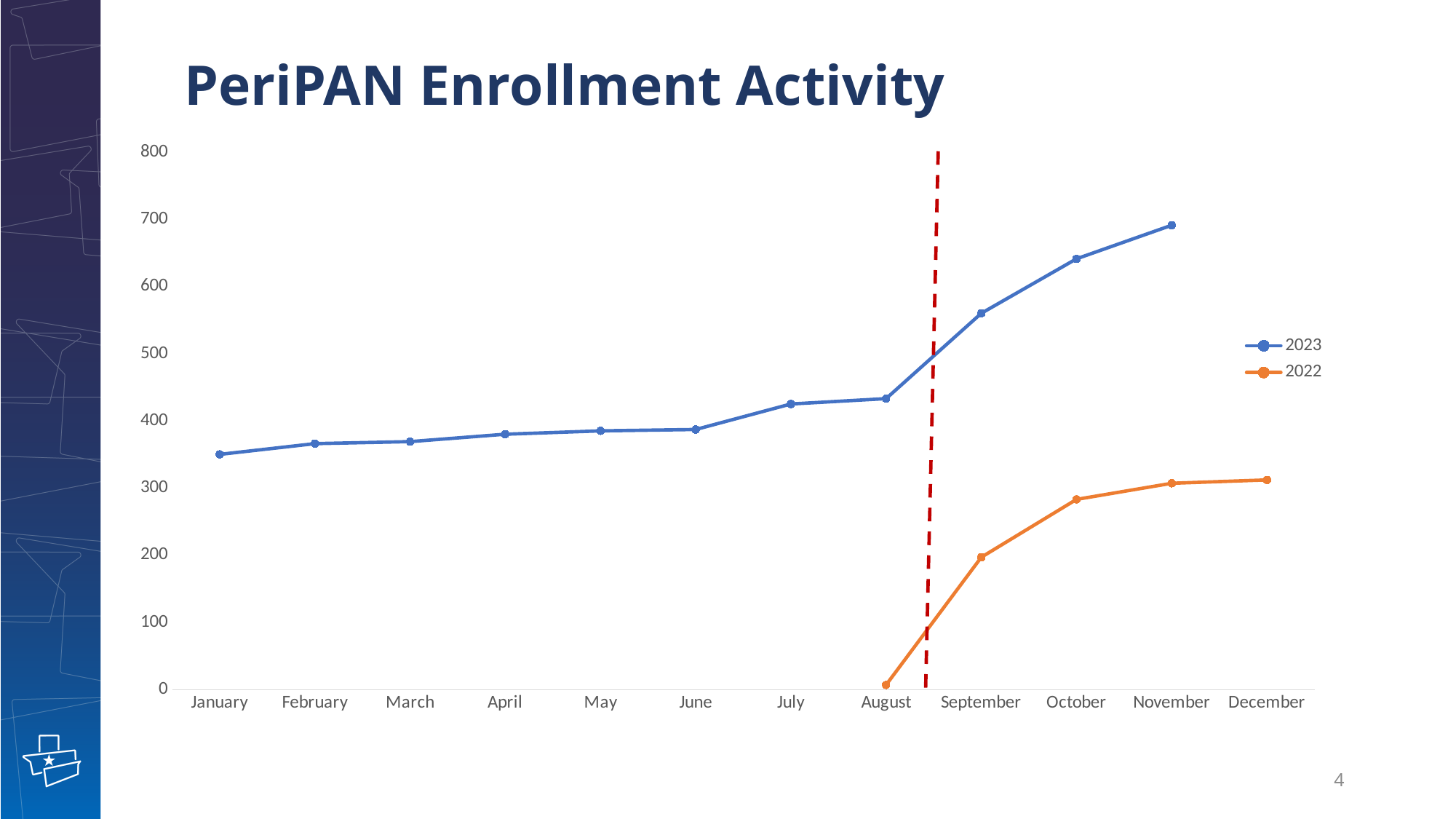
How many months are labelled along the x axis? 12 How many series does the legend list? 2 In which month does the 2022 series have its lowest value? August Is the 2023 value for January greater or less than 400? less What kind of chart is shown on the slide? line chart In which month does the 2023 series reach its highest value? November Is the 2022 value for September greater or less than 100? greater Is the 2022 value for December greater or less than 400? less Which series has the larger value in October, 2023 or 2022? 2023 Which series is drawn in orange? 2022 What is the title of the chart? PeriPAN Enrollment Activity